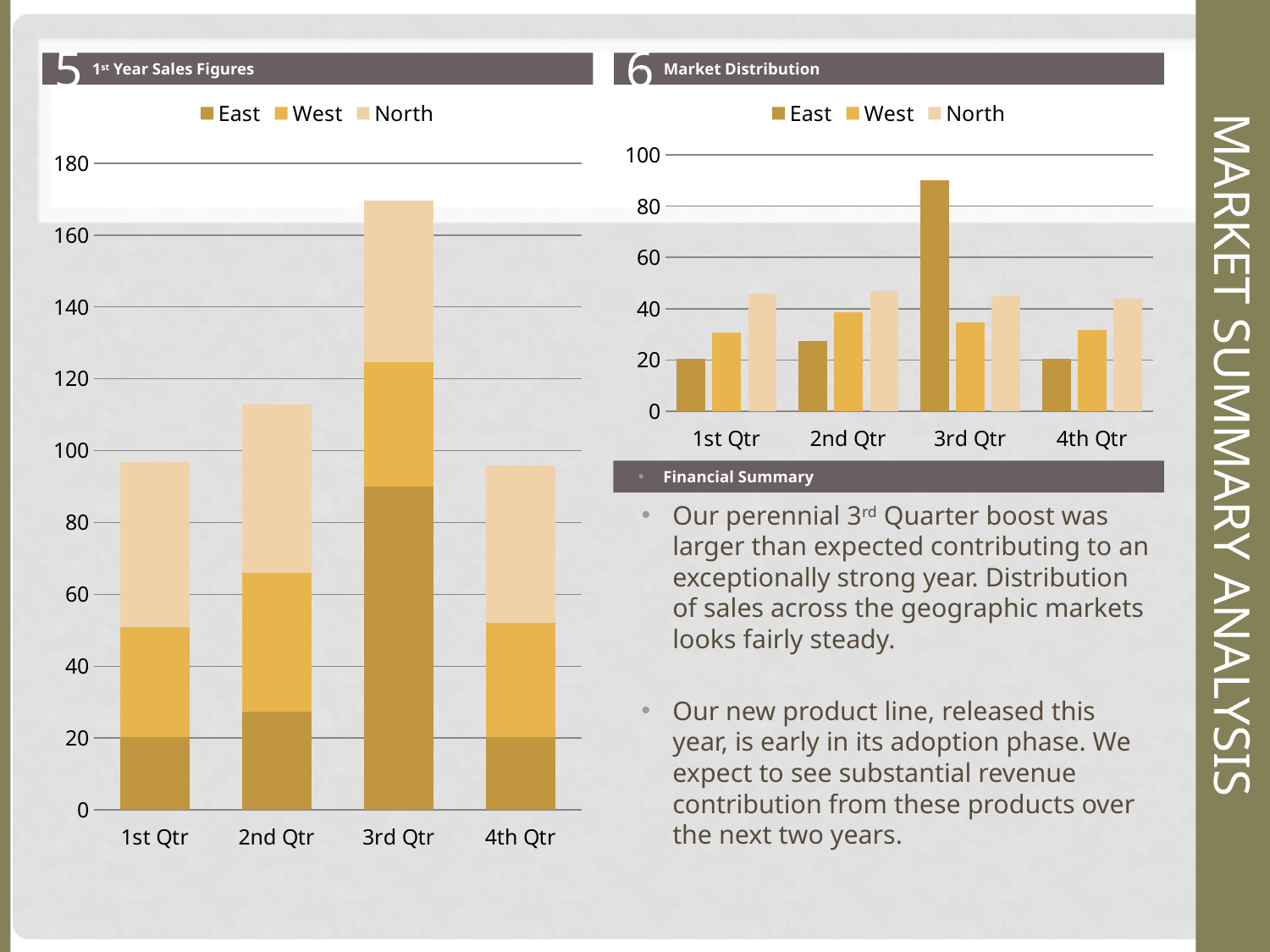
In the '1st Year Sales Figures' chart, is the total stacked bar for 1st Qtr greater or less than 100? less How many quarters are shown on the x axis of the 'Market Distribution' chart? 4 What kind of chart is the 'Market Distribution' chart? bar chart In the '1st Year Sales Figures' chart, which quarter has the tallest stacked bar? 3rd Qtr How many series does the legend of the '1st Year Sales Figures' chart list? 3 Which series is listed first in the legend of the 'Market Distribution' chart? East In the 'Market Distribution' chart, which is larger for 2nd Qtr, East or West? West In the 'Market Distribution' chart, is the East value for 1st Qtr greater or less than 40? less In the 'Market Distribution' chart, which quarter has the highest East value? 3rd Qtr What kind of chart is the '1st Year Sales Figures' chart? stacked bar chart In the 'Market Distribution' chart, is the East value for 3rd Qtr greater or less than 80? greater